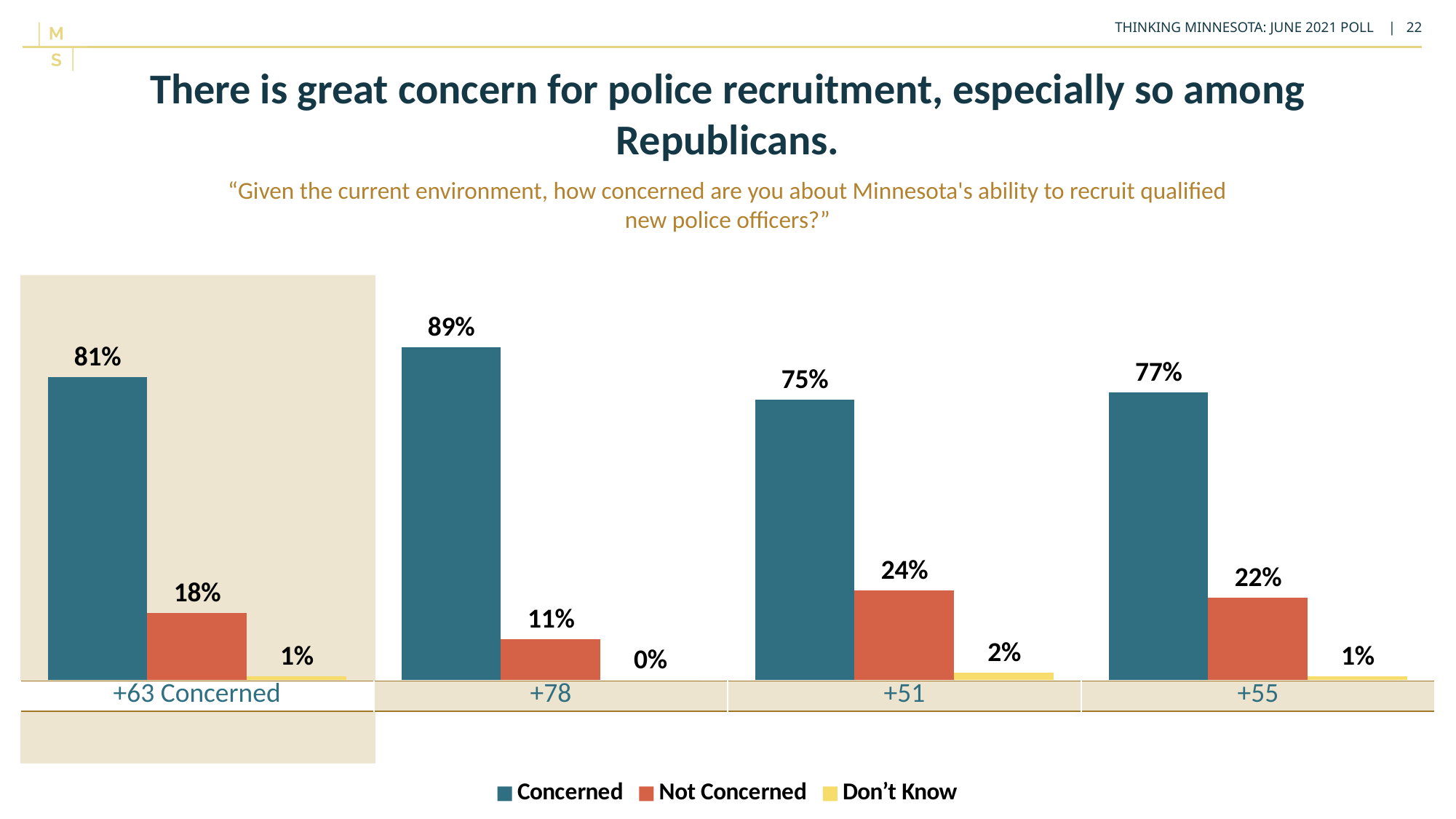
What is the Don't Know value for the third group from the left (labelled +51)? 2% What is the Not Concerned value for the second group from the left (labelled +78)? 11% Which group of bars has the highest Concerned value? The second group from the left (+78), at 89% What is the difference between the Concerned and Not Concerned values in the leftmost group? 63 percentage points Which group of bars has the lowest Concerned value? The third group from the left (+51), at 75% What type of chart is shown on the slide? Bar chart What are the three series named in the legend? Concerned, Not Concerned, Don't Know Is the Not Concerned value larger in the third group (+51) or the rightmost group (+55)? The third group (+51), at 24% How many groups of bars are shown in the chart? 4 What is the Concerned value for the leftmost group of bars? 81% What is the Not Concerned value for the rightmost group (labelled +55)? 22% How many series does the legend list? 3